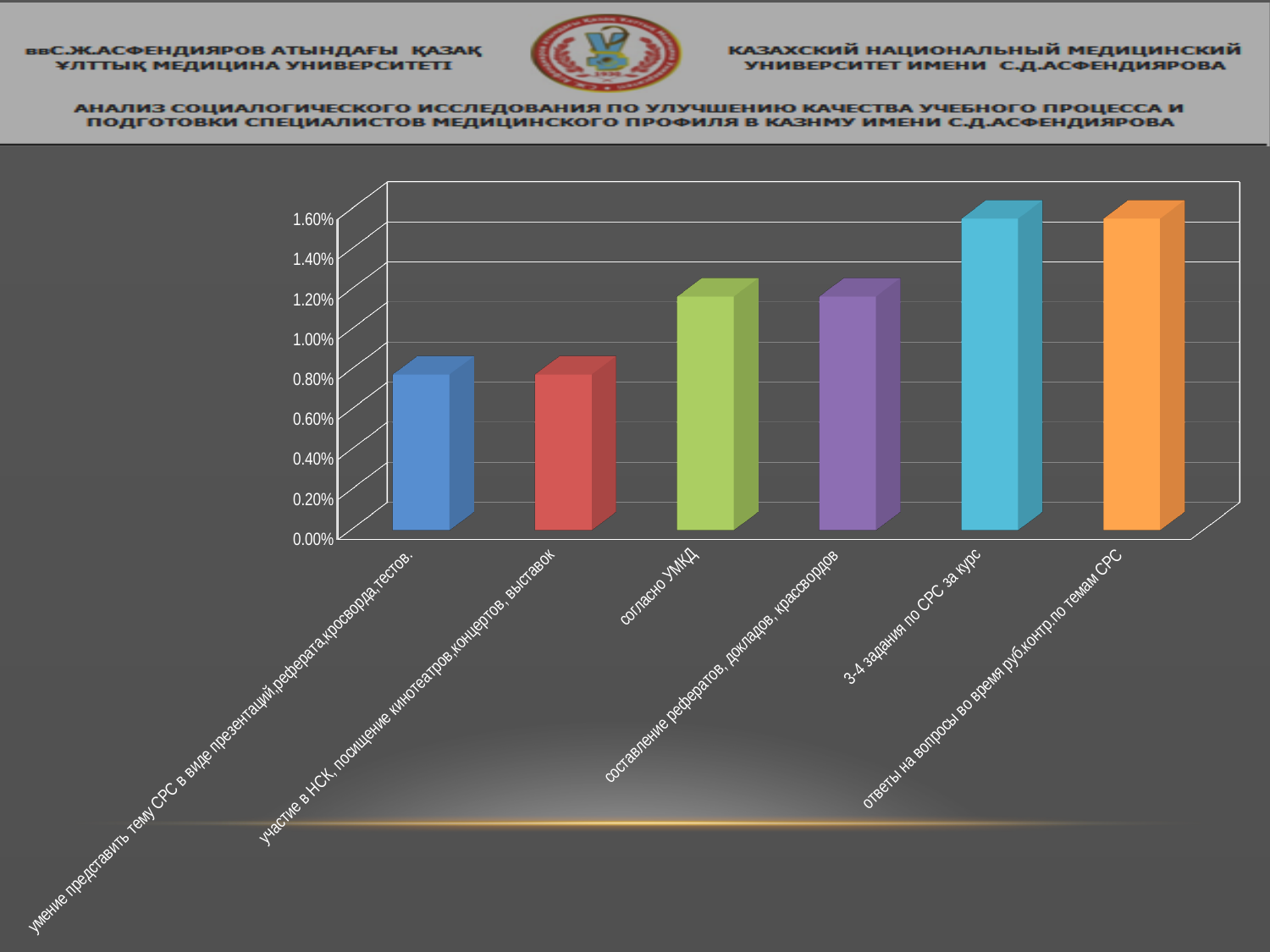
Is the value for "ответы на вопросы во время руб.контр.по темам СРС" greater or less than 1.40%? greater Is the value for "3-4 задания по СРС за курс" greater or less than 1.40%? greater Is the value for "составление рефератов, докладов, крассвордов" greater or less than 1.40%? less What is the highest tick label shown on the vertical axis? 1.60% Which is larger: the value for "3-4 задания по СРС за курс" or the value for "составление рефератов, докладов, крассвордов"? 3-4 задания по СРС за курс Which is larger: the value for "согласно УМКД" or the value for "участие в НСК, посещение кинотеатров,концертов, выставок"? согласно УМКД What kind of chart is shown on the slide? bar chart What colour is the bar for "согласно УМКД"? green How many categories are plotted in the chart? 6